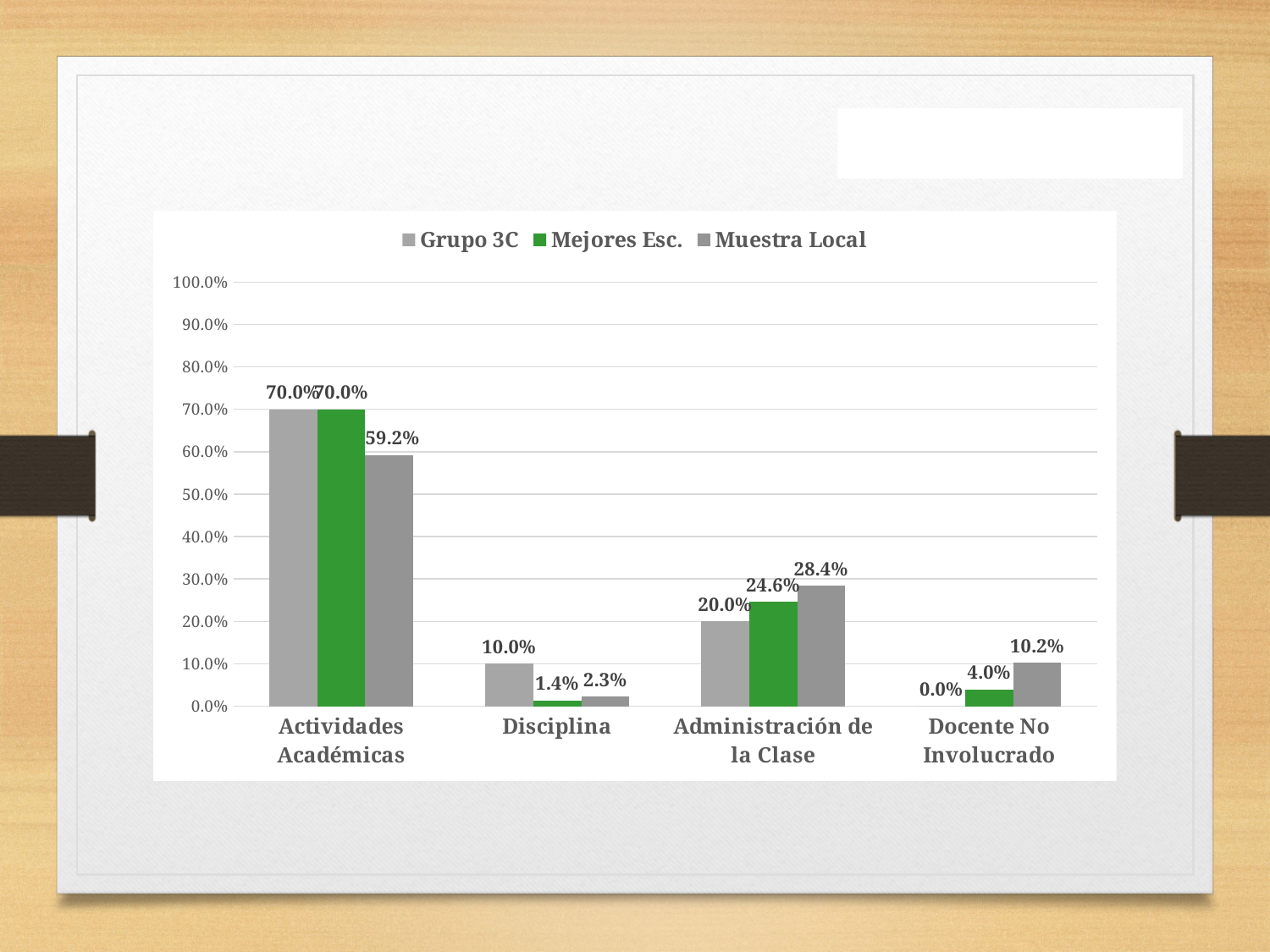
What kind of chart is shown on the slide? Bar chart What is the difference between the Muestra Local and Grupo 3C values in the Administración de la Clase category? 8.4% What is the value for Grupo 3C in the Disciplina category? 10.0% Which series is shown in green in the legend? Mejores Esc. In the Disciplina category, which is larger: Grupo 3C or Muestra Local? Grupo 3C What is the value for Muestra Local in the Actividades Académicas category? 59.2% How many categories are shown on the x axis? 4 What is the value for Grupo 3C in the Docente No Involucrado category? 0.0% What is the value for Mejores Esc. in the Administración de la Clase category? 24.6% Which category has the lowest value for Mejores Esc.? Disciplina Which category has the highest value for Muestra Local? Actividades Académicas How many series does the legend list? 3